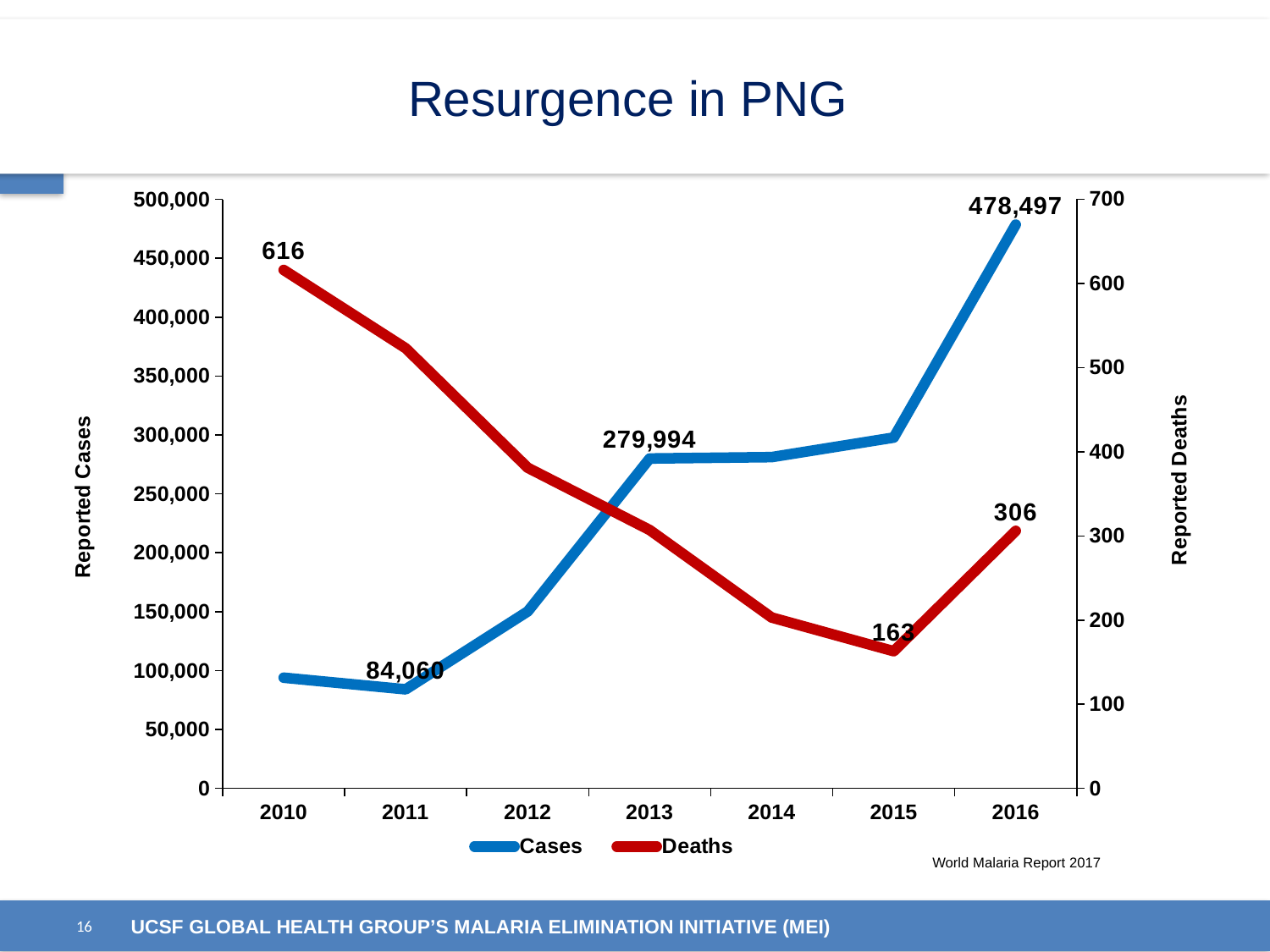
What kind of chart is shown on the slide? line chart What is the number of reported deaths in 2015? 163 What is the difference between reported cases in 2016 and 2013? 198,503 In which year are reported cases highest? 2016 By how much did reported deaths fall from 2010 to 2015? 453 In which year are reported deaths lowest? 2015 How many series does the legend list? 2 What is the number of reported deaths in 2010? 616 What is the number of reported cases in 2011? 84,060 Do reported deaths rise or fall from 2010 to 2015? fall Is the value for reported cases in 2014 greater or less than 300,000? less What is the number of reported cases in 2016? 478,497